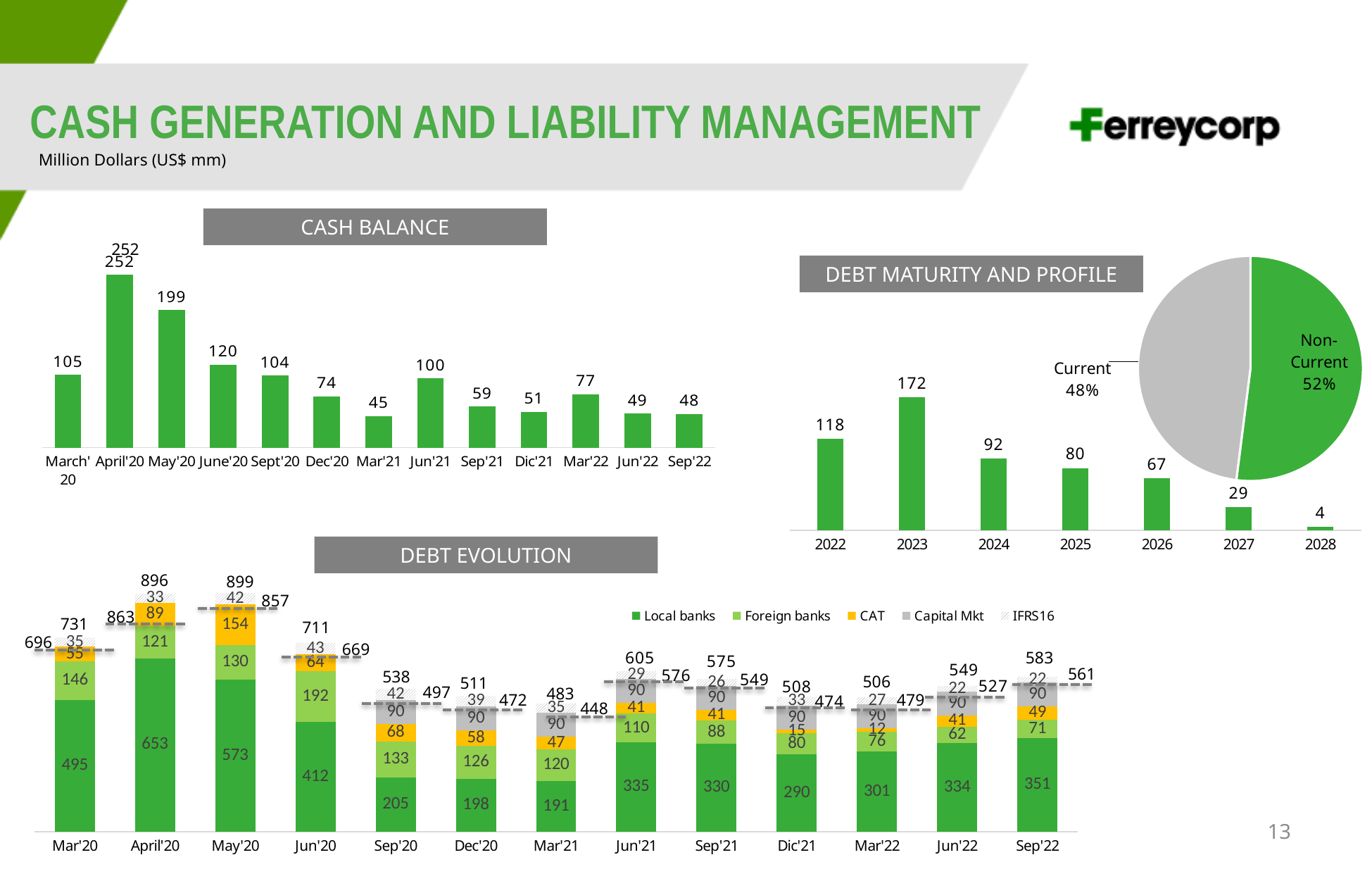
In the Debt Evolution chart, what is the total debt for May'20 (including IFRS16)? 899 In the Debt Evolution chart, how many series does the legend list? 5 In the Cash Balance chart, what is the difference between the cash balance in May'20 and Sep'22? 151 In the Cash Balance chart, what is the cash balance for April'20? 252 In the pie chart next to Debt Maturity and Profile, what share of debt is Non-Current? 52% In the Debt Maturity and Profile chart, do the values rise or fall from 2023 to 2028? fall In the Cash Balance chart, how many periods are plotted? 13 In the Cash Balance chart, which period has the lowest cash balance? Mar'21 In the Debt Maturity and Profile chart, what is the value for 2026? 67 In the Debt Evolution chart, which is larger: the Local banks value for April'20 or for May'20? April'20 In the Debt Maturity and Profile chart, which year has the highest debt maturity? 2023 In the Debt Evolution chart, what is the Local banks value for Sep'22? 351